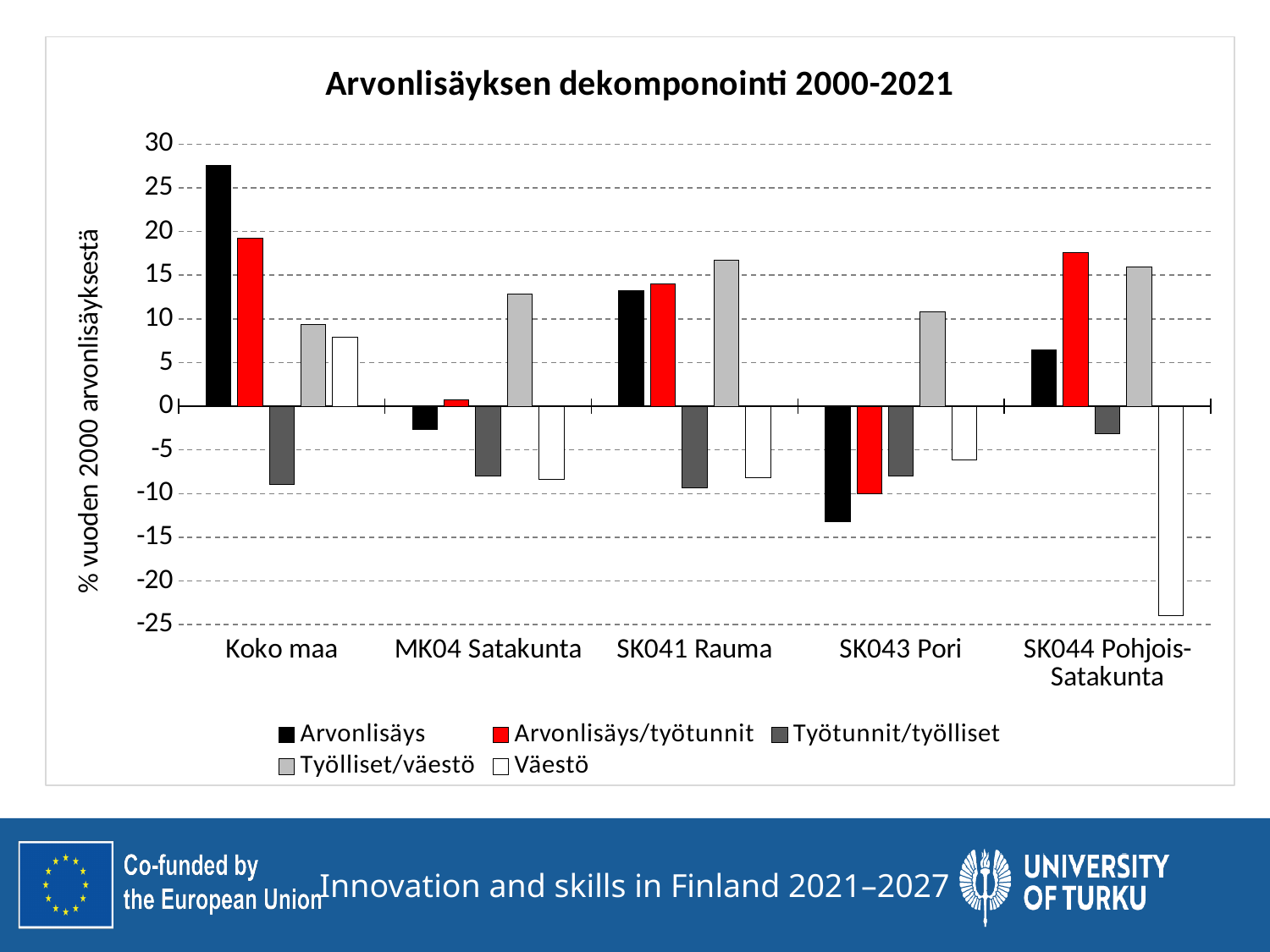
Is the Arvonlisäys/työtunnit value for Koko maa greater or less than 15? greater Is the Arvonlisäys value for Koko maa greater or less than 25? greater Which region has the lowest Arvonlisäys value? SK043 Pori Which region has the lowest Väestö value? SK044 Pohjois-Satakunta How many series does the legend list? 5 Which has the larger Työlliset/väestö value, SK041 Rauma or SK043 Pori? SK041 Rauma Which has the larger Arvonlisäys value, Koko maa or SK041 Rauma? Koko maa Is the Väestö value for SK044 Pohjois-Satakunta greater or less than -20? less What is the title of the chart? Arvonlisäyksen dekomponointi 2000-2021 Which region has the highest Arvonlisäys value? Koko maa How many regions (categories) are shown on the x axis? 5 What kind of chart is shown on the slide? bar chart